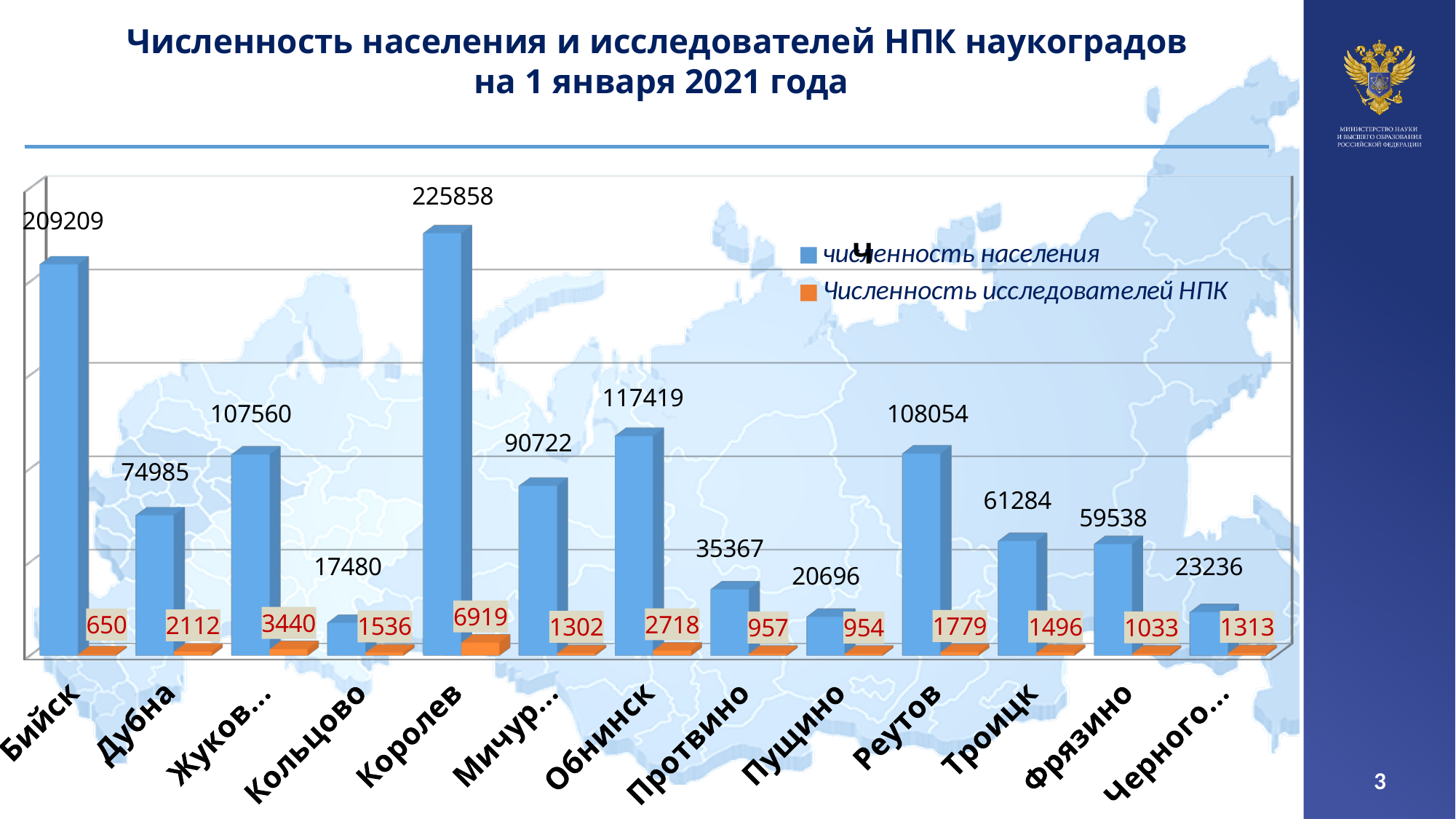
How many cities are shown on the x axis of the chart? 13 Which city has a larger population, Обнинск or Реутов? Обнинск What is the difference in the number of НПК researchers between Дубна and Троицк? 616 Which city has the lowest population in the chart? Кольцово What is the population (Численность населения) shown for Королев? 225858 What is the difference in population between Королев and Бийск? 16649 Which city has the highest population in the chart? Королев Which city has the lowest number of НПК researchers? Бийск How many НПК researchers (Численность исследователей НПК) are shown for Дубна? 2112 How many series does the legend list? 2 What is the population value shown for Обнинск? 117419 What type of chart is shown on the slide? Bar chart